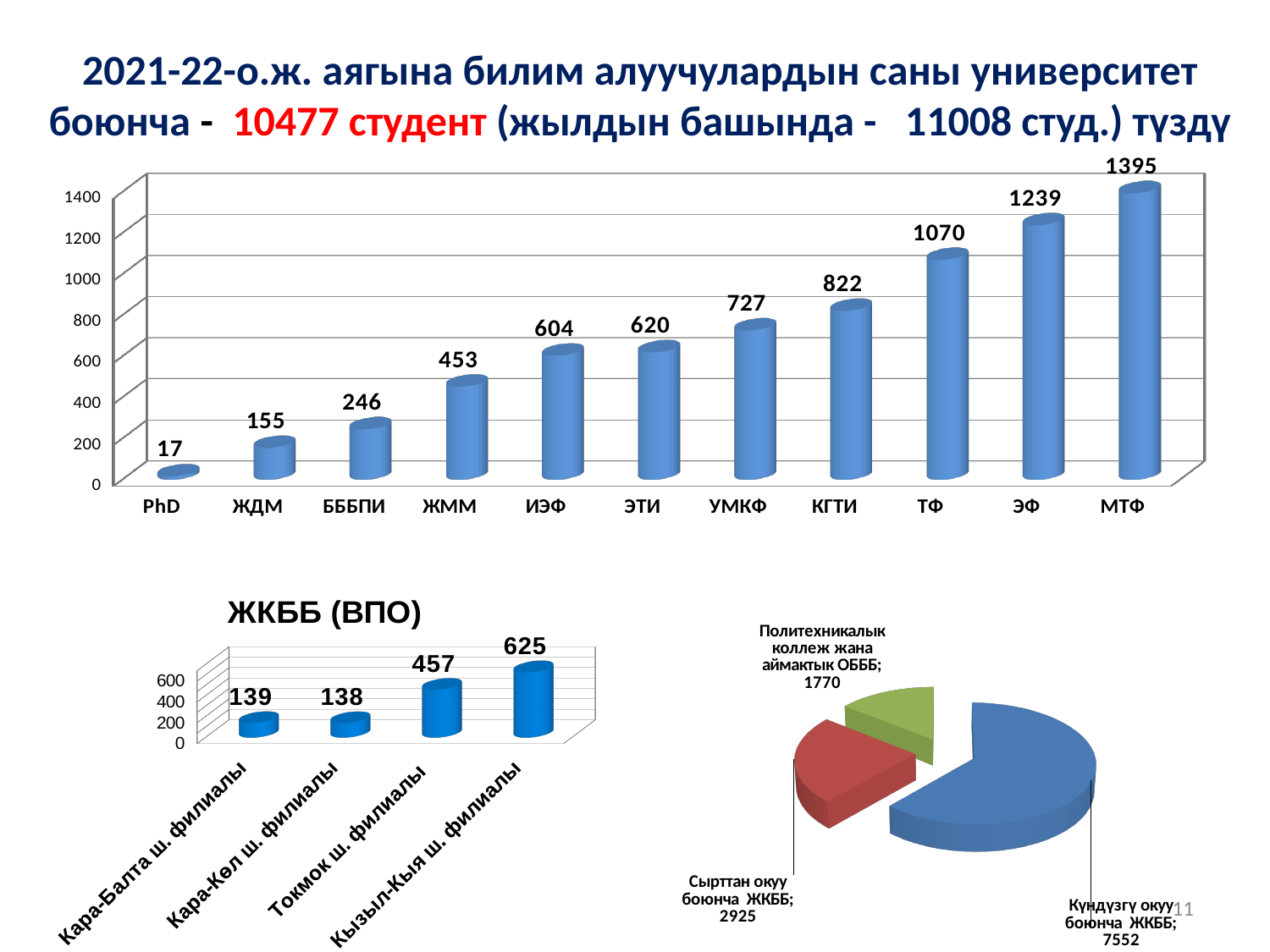
In the top bar chart, what is the value for КГТИ? 822 What kind of chart is shown at the bottom right of the slide? pie chart In the top bar chart, which category has the highest value? МТФ In the ЖКББ (ВПО) chart, what is the value for Токмок ш. филиалы? 457 In the pie chart at the bottom right, what is the value for Сырттан окуу боюнча ЖКББ? 2925 In the top bar chart, what is the value for МТФ? 1395 In the top bar chart, how many categories are shown on the x axis? 11 In the top bar chart, which category has the lowest value? PhD In the ЖКББ (ВПО) chart, which category has the highest value? Кызыл-Кыя ш. филиалы In the ЖКББ (ВПО) chart, what is the difference between the values for Кызыл-Кыя ш. филиалы and Кара-Балта ш. филиалы? 486 In the top bar chart, do the values rise or fall from left to right along the x axis? rise In the top bar chart, what is the difference between the values for ЭФ and ТФ? 169